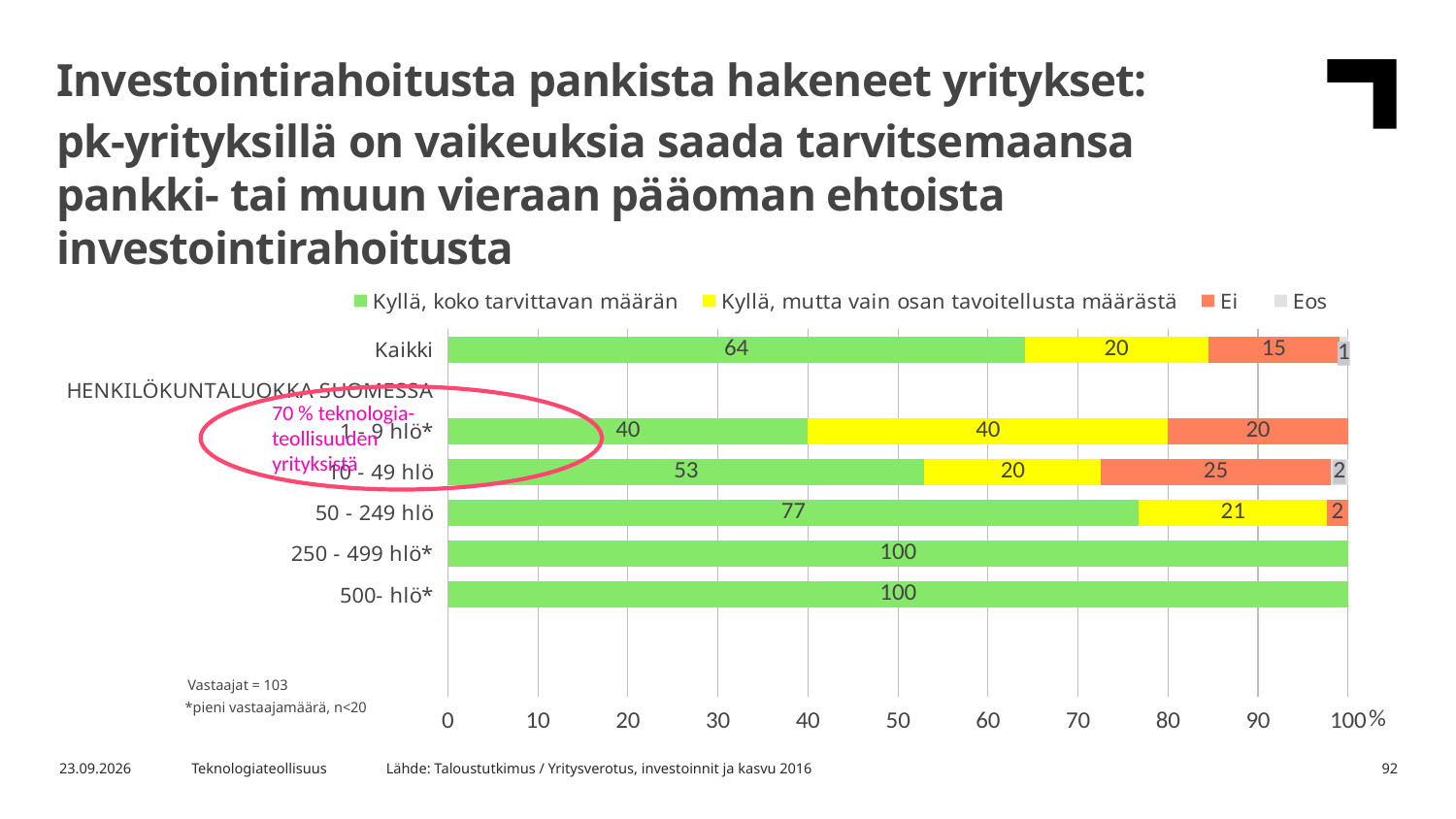
Which category has the lowest value for 'Kyllä, koko tarvittavan määrän'? 1 - 9 hlö* What is the value of 'Kyllä, mutta vain osan tavoitellusta määrästä' for the '1 - 9 hlö*' category? 40 What is the difference between the 'Kyllä, koko tarvittavan määrän' values for '50 - 249 hlö' and '10 - 49 hlö'? 24 What is the value of 'Ei' for the '10 - 49 hlö' category? 25 What is the value of 'Kyllä, koko tarvittavan määrän' for the 'Kaikki' category? 64 What is the total of the stacked bar for the 'Kaikki' category? 100 What type of chart is shown on the slide? stacked bar chart What is the value of 'Kyllä, koko tarvittavan määrän' for the '50 - 249 hlö' category? 77 Which category has the highest value for 'Ei'? 10 - 49 hlö How many series does the legend list? 4 Which is larger: the 'Ei' value for 'Kaikki' or the 'Ei' value for '1 - 9 hlö*'? 1 - 9 hlö*